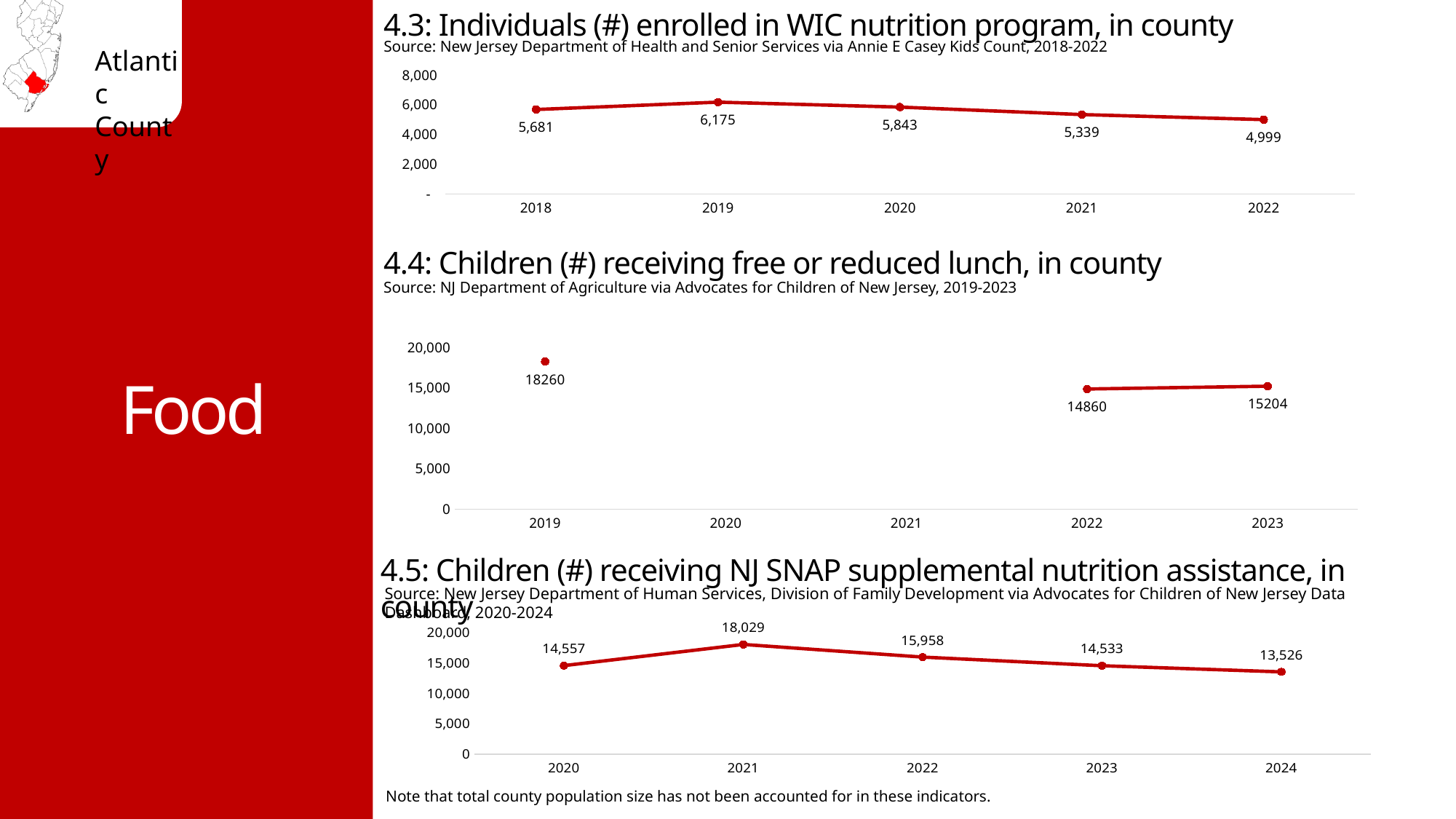
In the chart '4.3: Individuals (#) enrolled in WIC nutrition program, in county', how many data points are plotted? 5 In the chart '4.4: Children (#) receiving free or reduced lunch, in county', which is larger, the value for 2022 or 2023? 2023 In the chart '4.3: Individuals (#) enrolled in WIC nutrition program, in county', what is the difference between the 2018 and 2022 values? 682 In the chart '4.5: Children (#) receiving NJ SNAP supplemental nutrition assistance, in county', what is the value for 2021? 18,029 In the chart '4.4: Children (#) receiving free or reduced lunch, in county', what is the value for 2019? 18260 In the chart '4.5: Children (#) receiving NJ SNAP supplemental nutrition assistance, in county', do the values rise or fall from 2021 to 2024? fall In the chart '4.3: Individuals (#) enrolled in WIC nutrition program, in county', what is the value for 2019? 6,175 In the chart '4.4: Children (#) receiving free or reduced lunch, in county', how many data points are plotted? 3 In the chart '4.3: Individuals (#) enrolled in WIC nutrition program, in county', which year has the lowest value? 2022 In the chart '4.5: Children (#) receiving NJ SNAP supplemental nutrition assistance, in county', what is the difference between the 2021 and 2024 values? 4,503 What kind of chart is '4.3: Individuals (#) enrolled in WIC nutrition program, in county'? line chart In the chart '4.5: Children (#) receiving NJ SNAP supplemental nutrition assistance, in county', which year has the highest value? 2021